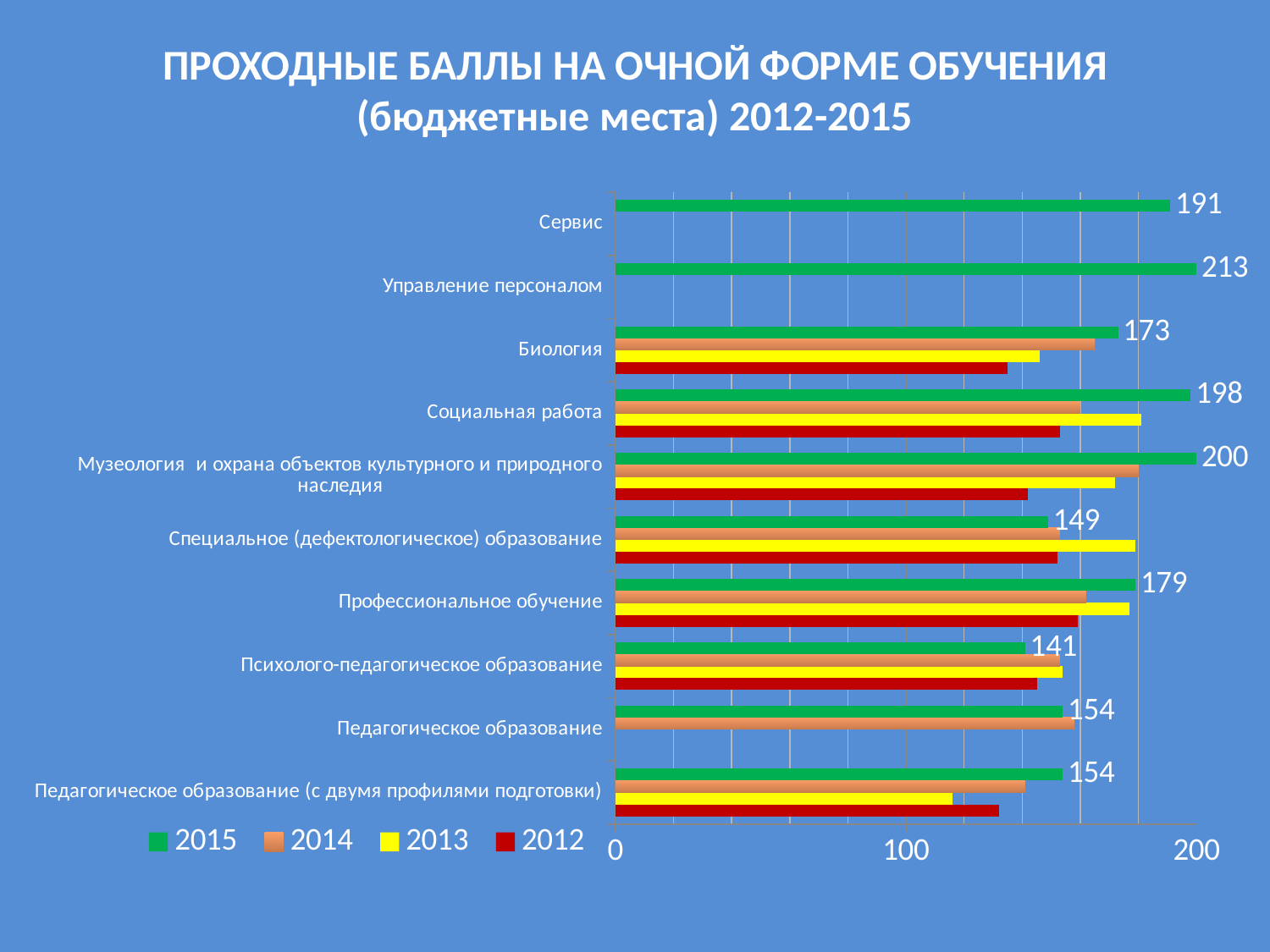
How many categories are shown on the chart? 10 Which has the larger 2015 value, Биология or Социальная работа? Социальная работа What is the difference between the 2015 values for Управление персоналом and Сервис? 22 Which category has the highest 2015 value? Управление персоналом What is the 2015 value for Управление персоналом? 213 How many series does the legend list? 4 What is the difference between the 2015 values for Профессиональное обучение and Специальное (дефектологическое) образование? 30 What is the 2015 value for Биология? 173 What kind of chart is shown on the slide? bar chart What is the 2015 value for Психолого-педагогическое образование? 141 Which category has the lowest 2015 value? Психолого-педагогическое образование Is the 2012 value for Биология greater or less than 200? less